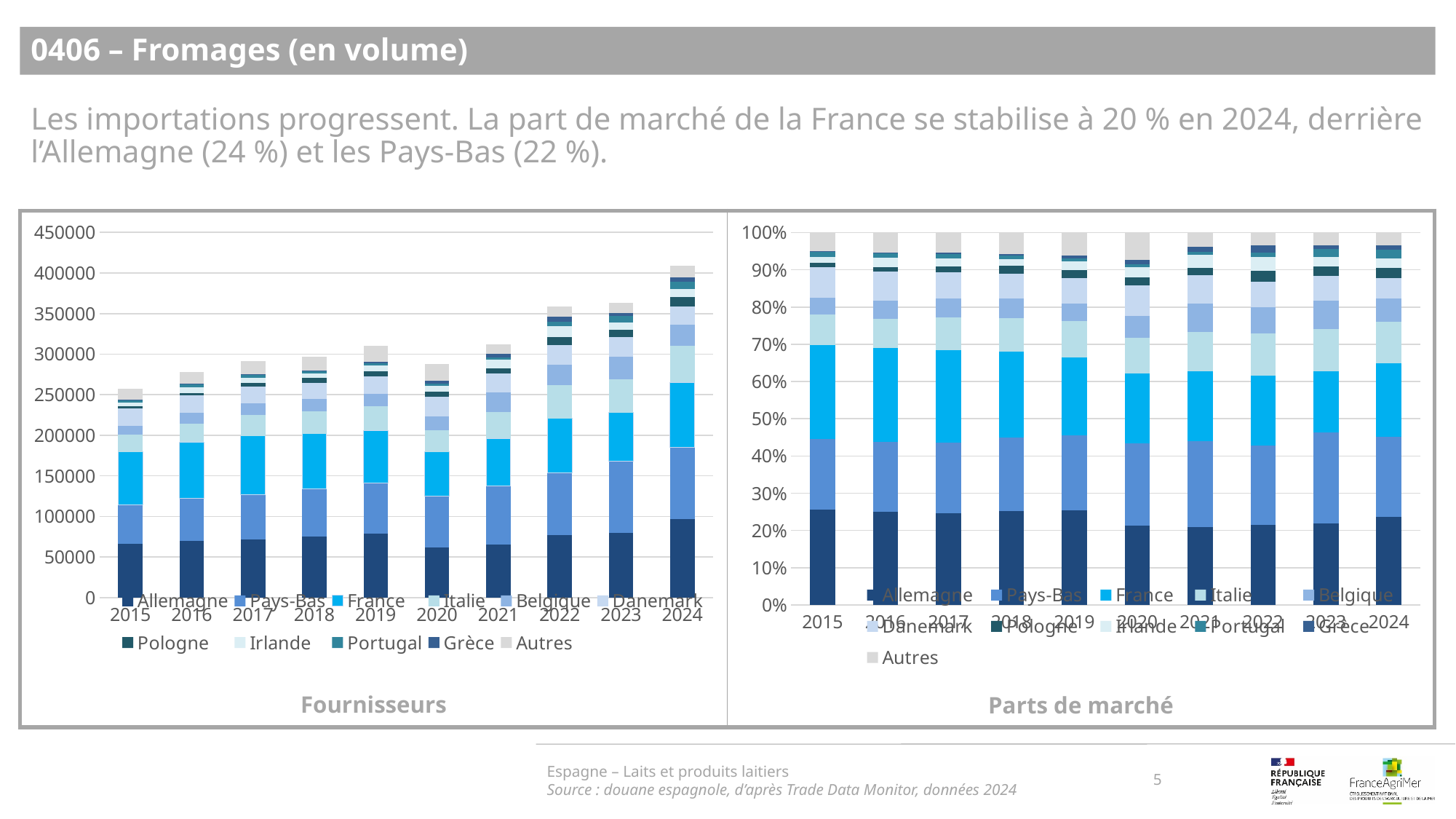
In the 'Fournisseurs' chart, is the total for 2022 larger or smaller than the total for 2021? larger What is the title of the chart on the right of the slide? Parts de marché In the 'Fournisseurs' chart, which year has the highest total bar? 2024 What kind of chart is the 'Parts de marché' chart? 100% stacked bar chart In the 'Fournisseurs' chart, do the total bars generally rise or fall from 2015 to 2024? rise In the 'Fournisseurs' chart, is the total for 2024 greater or less than 400000? greater In the 'Fournisseurs' chart, which year has the lowest total bar? 2015 In the 'Fournisseurs' chart, is the total for 2020 greater or less than 300000? less How many years are shown on the x axis of the 'Fournisseurs' chart? 10 How many series does the legend of the 'Parts de marché' chart list? 11 What kind of chart is the 'Fournisseurs' chart? stacked bar chart In the 'Fournisseurs' chart, is the total for 2022 greater or less than 350000? greater